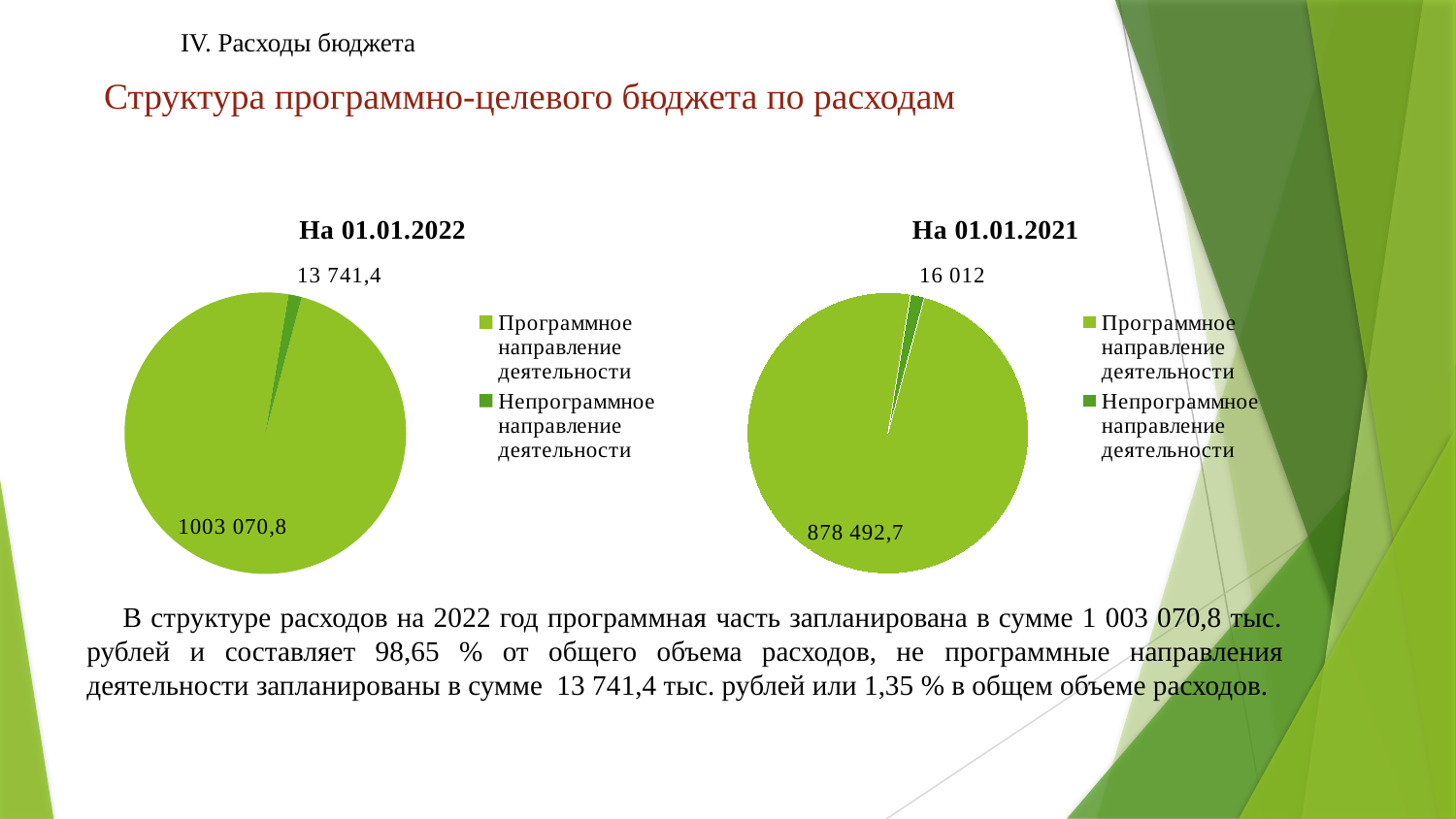
In the pie chart titled "На 01.01.2021", what is the total of the two slices? 894 504,7 In the pie chart titled "На 01.01.2021", what is the value for Программное направление деятельности? 878 492,7 In the pie chart titled "На 01.01.2021", what is the value for Непрограммное направление деятельности? 16 012 Which is larger: the Непрограммное направление деятельности value in the "На 01.01.2022" chart or in the "На 01.01.2021" chart? На 01.01.2021 What type of chart is used for "На 01.01.2021"? Pie chart How many slices does the pie chart titled "На 01.01.2022" have? 2 In the pie chart titled "На 01.01.2022", what is the value for Программное направление деятельности? 1003 070,8 In the pie chart titled "На 01.01.2021", which category has the smallest slice? Непрограммное направление деятельности In the pie chart titled "На 01.01.2022", which category has the largest slice? Программное направление деятельности In the pie chart titled "На 01.01.2022", what is the value for Непрограммное направление деятельности? 13 741,4 How many entries does the legend of the "На 01.01.2022" chart list? 2 In the pie chart titled "На 01.01.2022", what is the difference between the Программное and Непрограммное values? 989 329,4